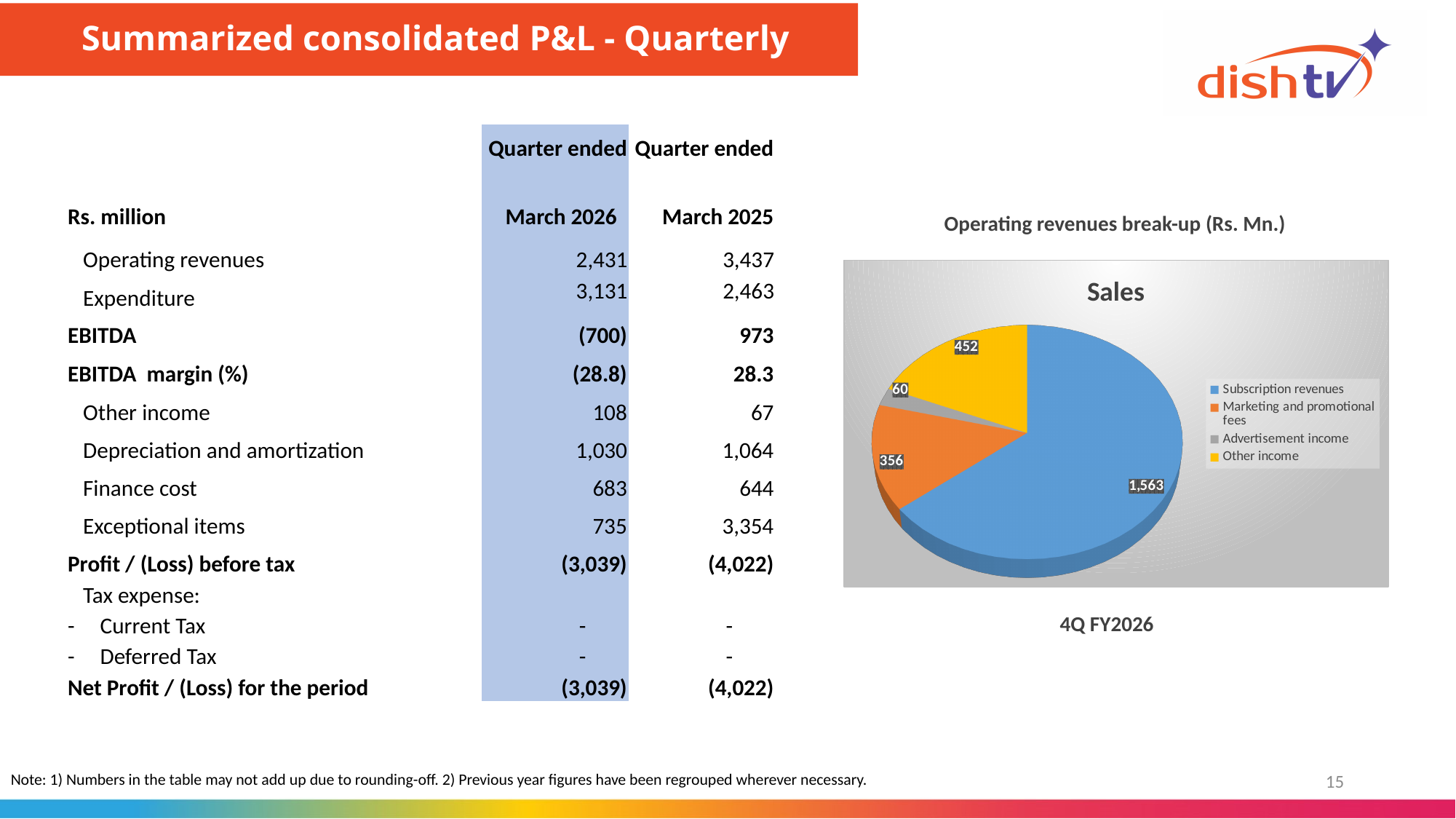
What colour is the Other income slice in the pie chart? Yellow What is the value for Advertisement income in the pie chart? 60 What is the difference between Subscription revenues and Marketing and promotional fees in the pie chart? 1,207 Which category has the smallest slice in the pie chart? Advertisement income Which is larger in the pie chart, Other income or Marketing and promotional fees? Other income What is the total of all slices in the pie chart? 2,431 Which category has the largest slice in the pie chart? Subscription revenues What is the value for Other income in the pie chart? 452 What is the value for Subscription revenues in the pie chart? 1,563 What kind of chart is shown on the slide? Pie chart How many categories does the pie chart show? 4 What is the value for Marketing and promotional fees in the pie chart? 356